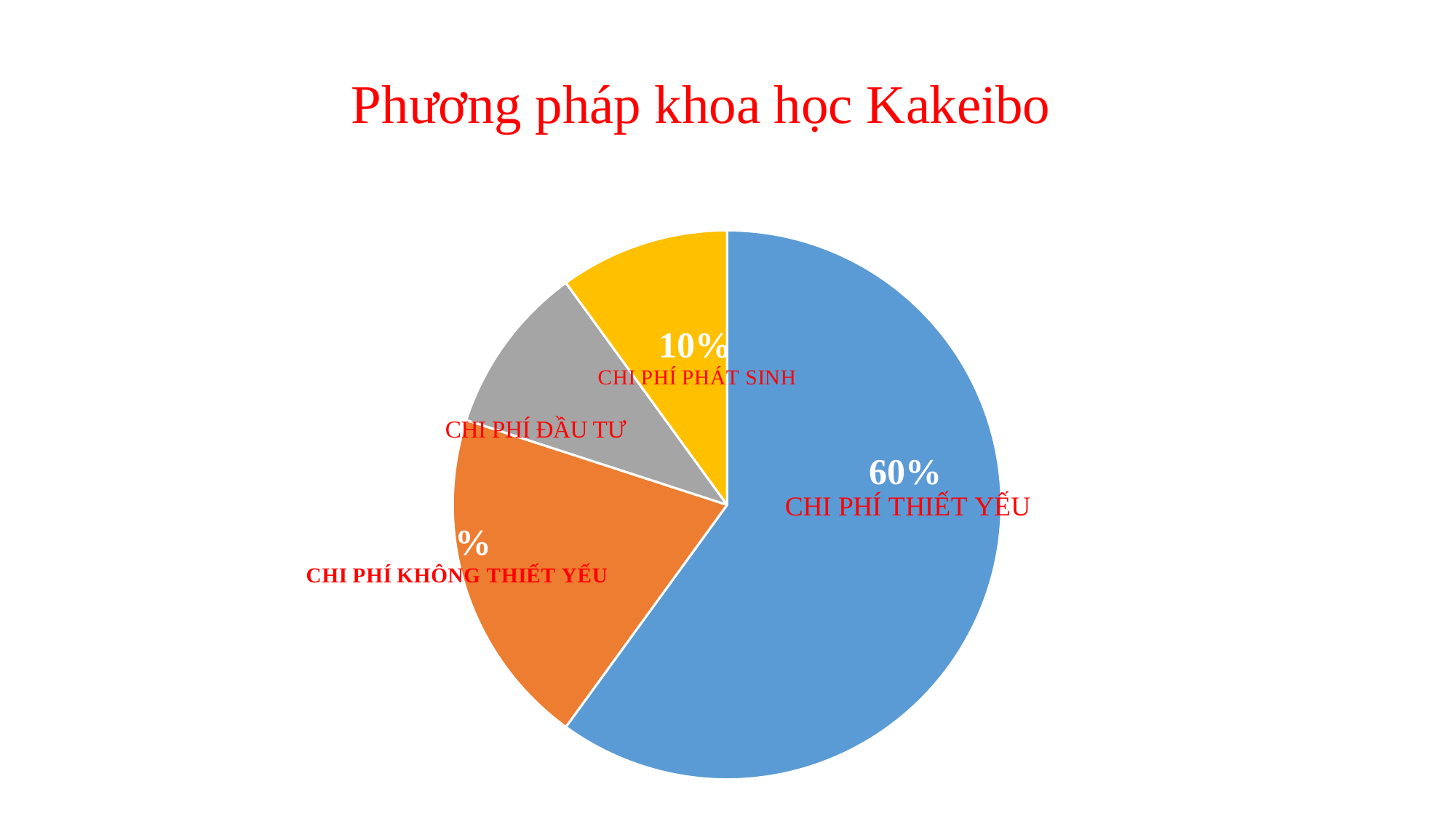
Which slice is larger, CHI PHÍ KHÔNG THIẾT YẾU or CHI PHÍ PHÁT SINH? CHI PHÍ KHÔNG THIẾT YẾU What share of the pie does CHI PHÍ THIẾT YẾU represent? 60% Which category has the largest slice of the pie? CHI PHÍ THIẾT YẾU What kind of chart is shown on the slide? pie chart What percentage is shown for CHI PHÍ PHÁT SINH? 10% Which slice is larger, CHI PHÍ THIẾT YẾU or CHI PHÍ KHÔNG THIẾT YẾU? CHI PHÍ THIẾT YẾU What is the title of the slide? Phương pháp khoa học Kakeibo How many slices does the pie chart have? 4 What colour is the slice for CHI PHÍ PHÁT SINH? yellow What percentage is shown for CHI PHÍ THIẾT YẾU? 60% What is the difference between the percentages for CHI PHÍ THIẾT YẾU and CHI PHÍ PHÁT SINH? 50%